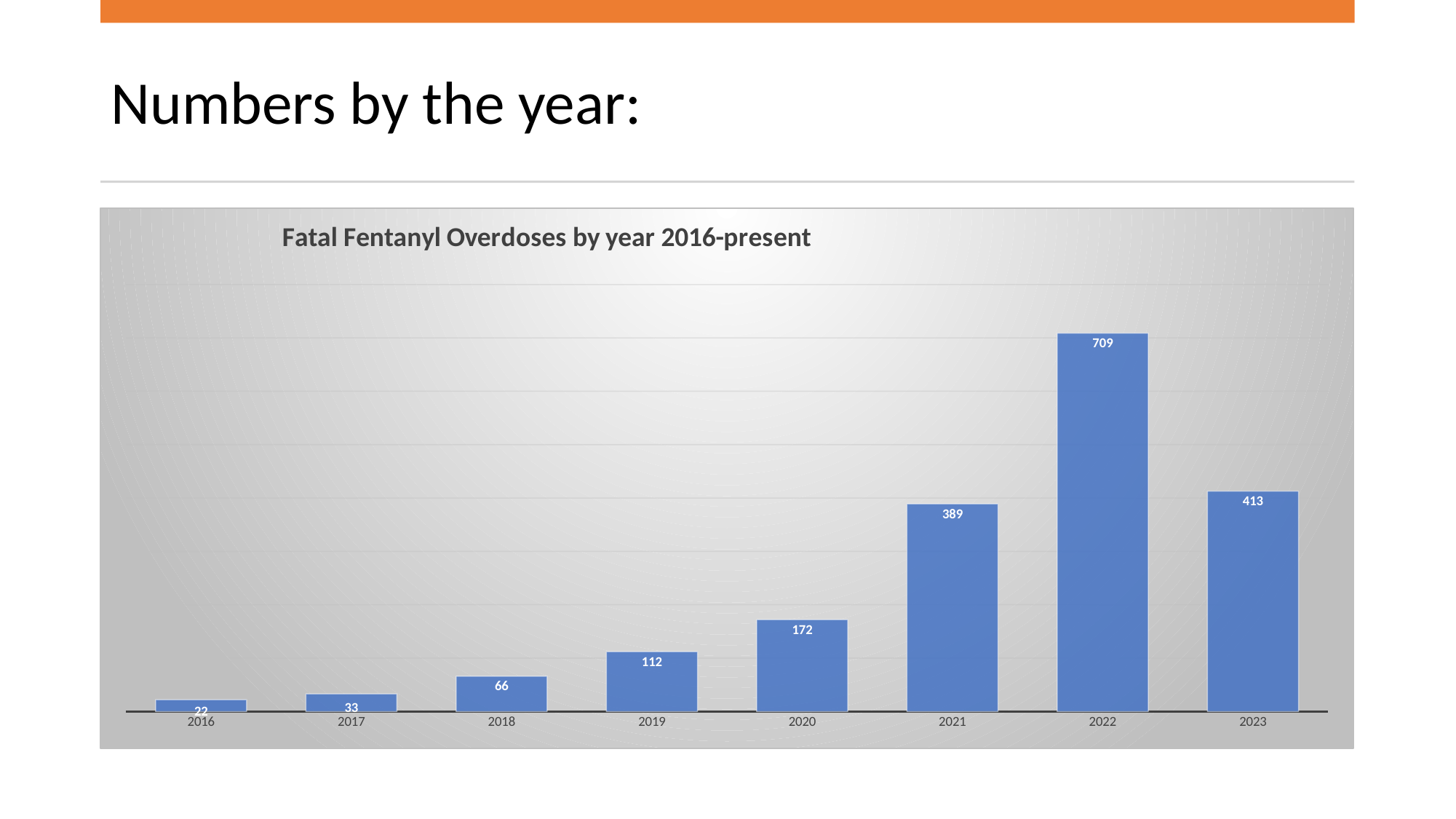
What is the title of the chart? Fatal Fentanyl Overdoses by year 2016-present What is the value for 2022? 709 What is the difference between the values for 2022 and 2021? 320 Which is larger, the value for 2021 or the value for 2023? 2023 Which year has the lowest value? 2016 How many years are shown on the x axis? 8 What is the value for 2019? 112 Which year has the highest value? 2022 Do the values rise or fall from 2016 to 2022? Rise What kind of chart is this? Bar chart What is the difference between the values for 2020 and 2019? 60 What is the value for 2023? 413